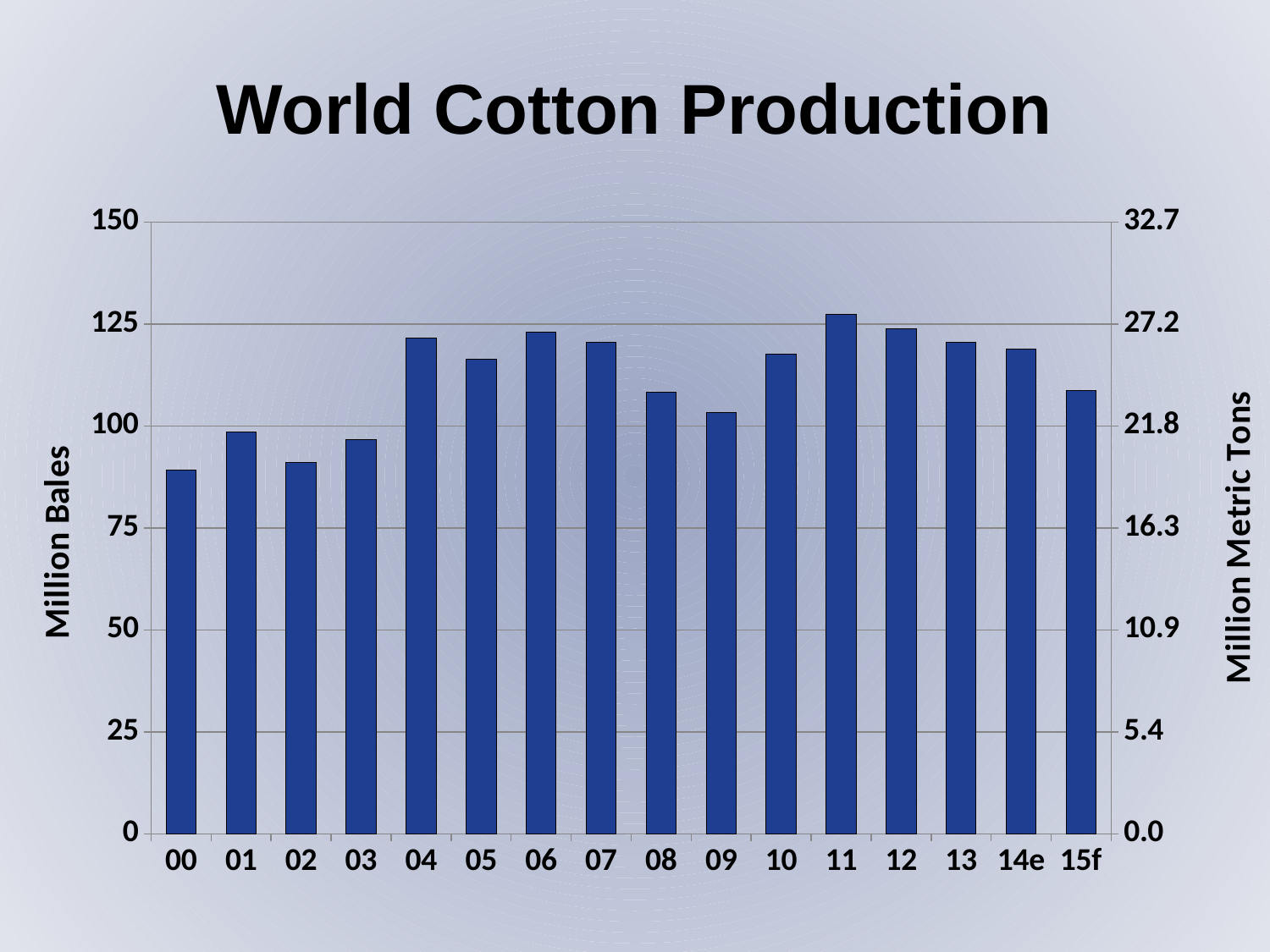
What is the label of the left vertical axis? Million Bales How many years (bars) are shown on the x axis? 16 Is the value for 02 greater or less than 100 million bales? less Which year has the highest world cotton production? 11 Which year has the larger production, 03 or 04? 04 Is the value for 00 greater or less than 100 million bales? less Is the value for 11 greater or less than 125 million bales? greater Do the values rise or fall from 11 to 15f? fall What kind of chart is shown on the slide? bar chart What is the title of the chart? World Cotton Production Which year has the larger production, 09 or 11? 11